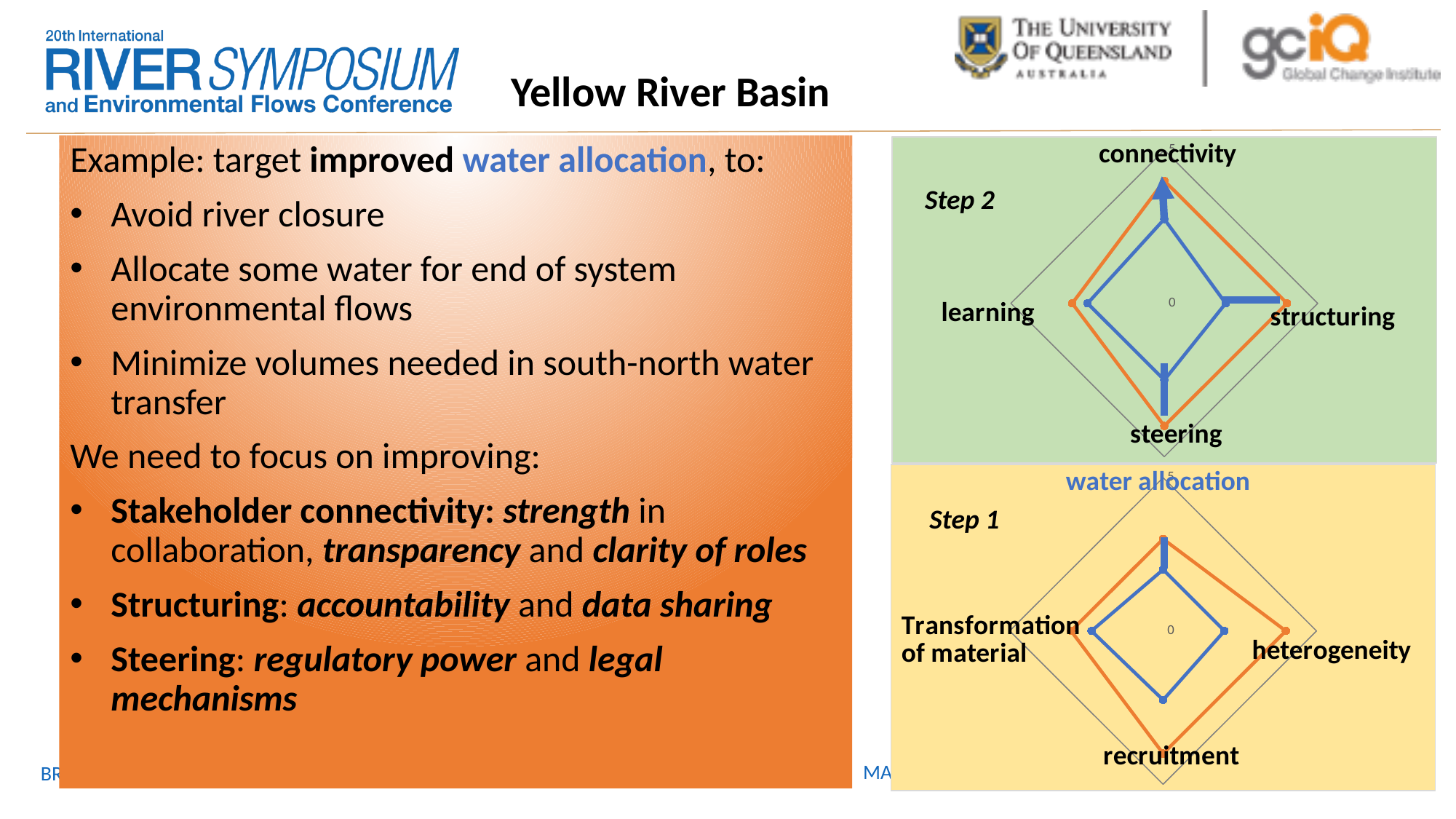
How many axes (categories) does the Step 1 radar chart have? 4 On the Step 1 radar chart, which axis label is written in blue text? water allocation On the Step 2 radar chart, on which axis does the blue series have its lowest value? structuring On the Step 2 radar chart, which series extends further along the learning axis, the orange line or the blue line? orange On the Step 1 radar chart, which series extends further along the heterogeneity axis, the orange line or the blue line? orange What kind of chart is the Step 2 chart on the right of the slide? radar chart How many data series (lines) are plotted on the Step 2 radar chart? 2 How many axes (categories) does the Step 2 radar chart have? 4 How many data series (lines) are plotted on the Step 1 radar chart? 2 What kind of chart is the Step 1 chart at the bottom right of the slide? radar chart What value is printed at the centre of the Step 2 radar chart? 0 On the Step 1 radar chart, which series extends further along the recruitment axis, the orange line or the blue line? orange